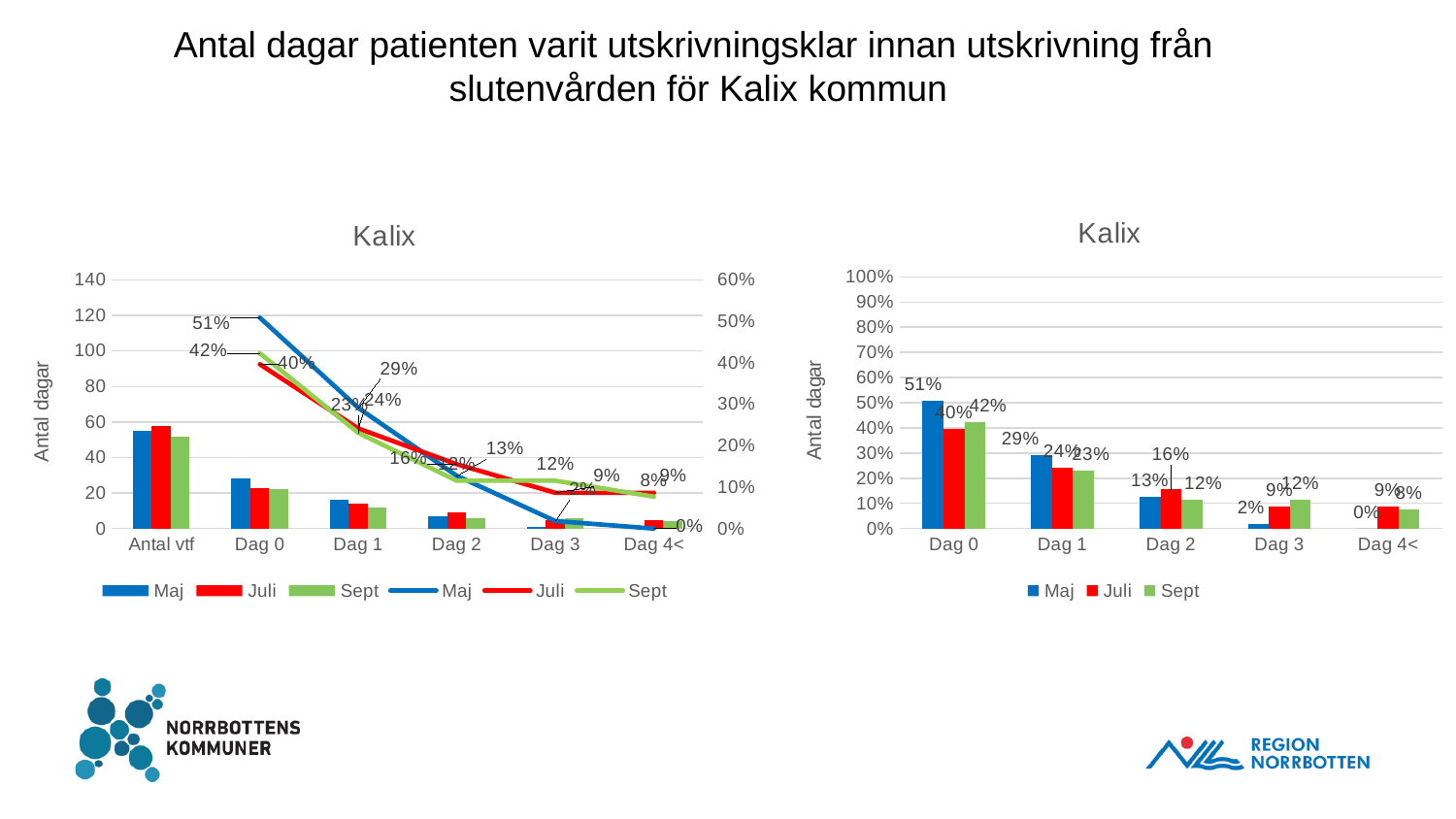
On the left-hand chart, how many categories are shown on the x axis? 6 On the right-hand chart, what is the value for Juli at Dag 2? 16% On the right-hand chart, which category has the lowest value for Maj? Dag 4< On the right-hand chart, how many series does the legend list? 3 On the right-hand chart, what is the value for Sept at Dag 3? 12% On the right-hand chart, which category has the highest value for Maj? Dag 0 On the right-hand chart, what is the value for Maj at Dag 0? 51% On the right-hand chart, what is the value for Maj at Dag 4<? 0% On the right-hand chart, what is the difference between the Maj and Juli values at Dag 0? 11% What kind of chart is the right-hand chart? Bar chart On the right-hand chart, which is larger at Dag 3: Juli or Sept? Sept On the left-hand chart, is the Maj bar for Antal vtf greater or less than 40? greater